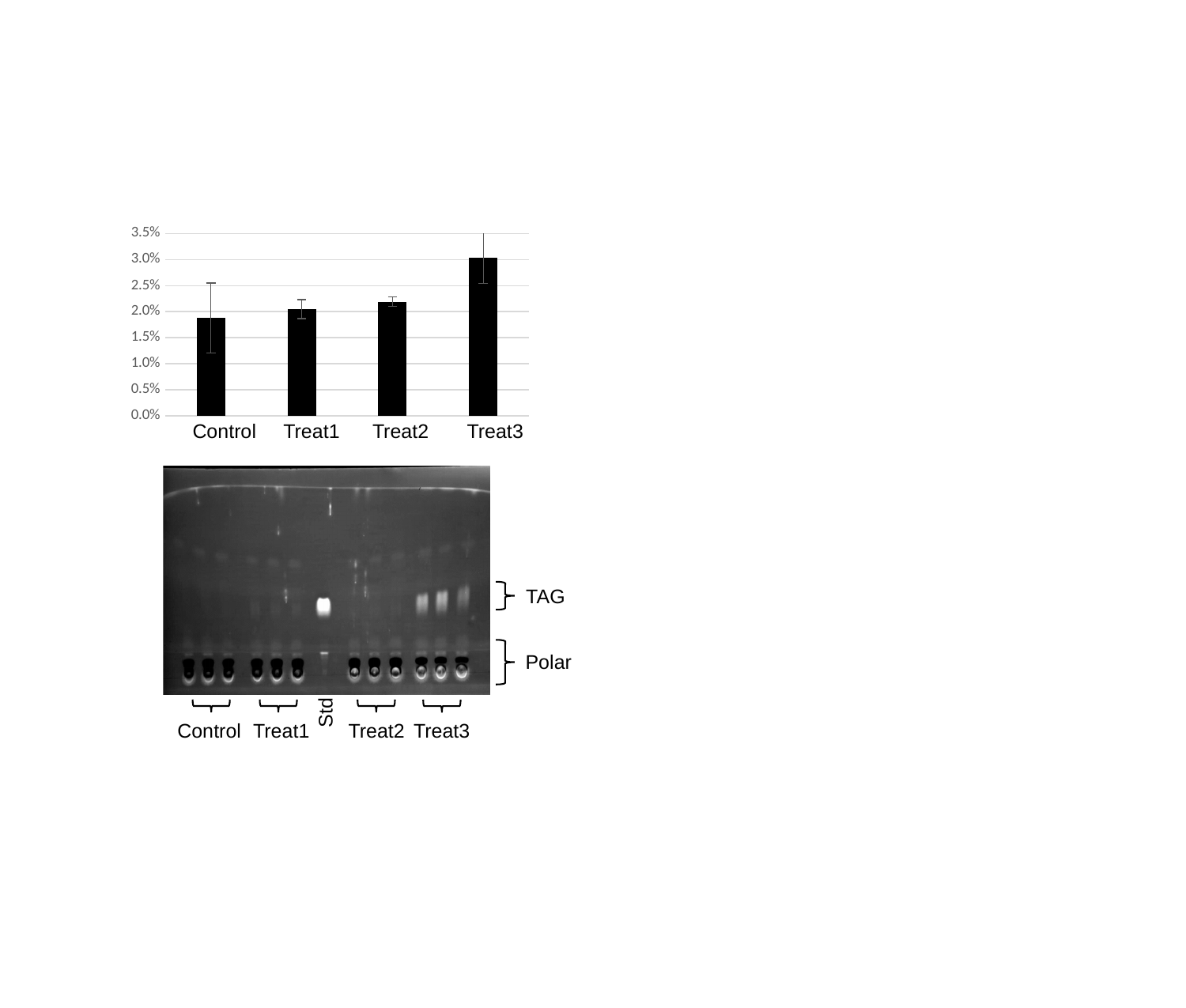
Do the bar values rise or fall from Control to Treat3 along the x axis? rise Which category has the highest bar in the bar chart? Treat3 Is the value for Treat3 greater or less than 2.5%? greater Is the value for Treat1 greater or less than 1.5%? greater Is the value for Control greater or less than 2.0%? less Which category has the lowest bar in the bar chart? Control What kind of chart is shown at the top of the slide? bar chart What is the highest value labelled on the y axis of the bar chart? 3.5% How many categories are shown on the x axis of the bar chart? 4 Which is larger in the bar chart, the value for Treat2 or the value for Control? Treat2